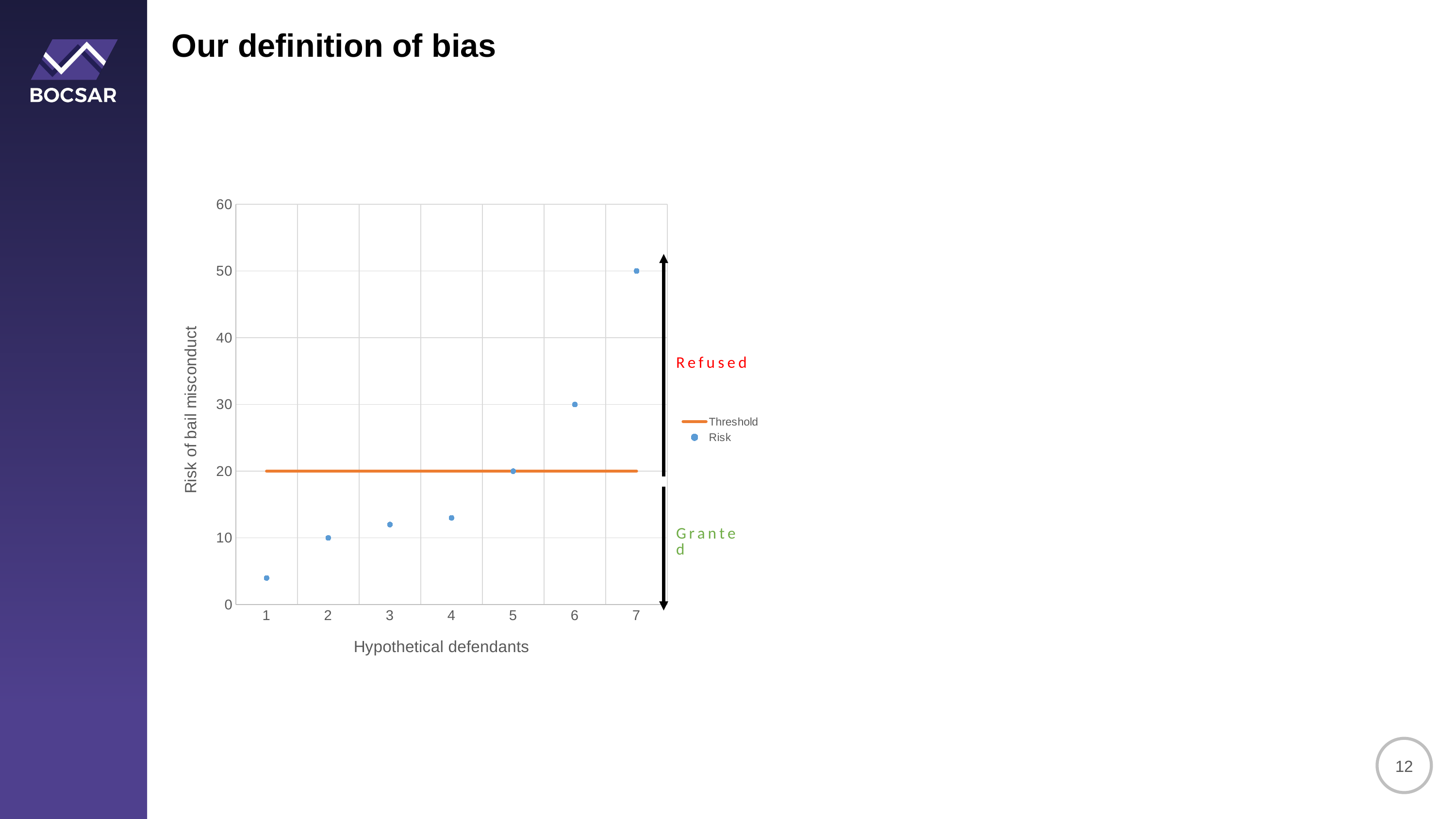
What is the risk of bail misconduct for hypothetical defendant 6? 30 What is the risk of bail misconduct for hypothetical defendant 7? 50 How many series does the legend list? 2 What is the difference in risk of bail misconduct between defendant 7 and defendant 6? 20 Is the risk of bail misconduct for defendant 4 greater or less than 20? less What is the risk of bail misconduct for hypothetical defendant 2? 10 Do the risk values rise or fall as the defendant number increases from 1 to 7? rise Is the risk of bail misconduct for defendant 1 greater or less than 10? less Which hypothetical defendant has the lowest risk of bail misconduct? 1 How many hypothetical defendants are plotted on the chart? 7 Which hypothetical defendant has the highest risk of bail misconduct? 7 At what risk value is the Threshold line drawn? 20